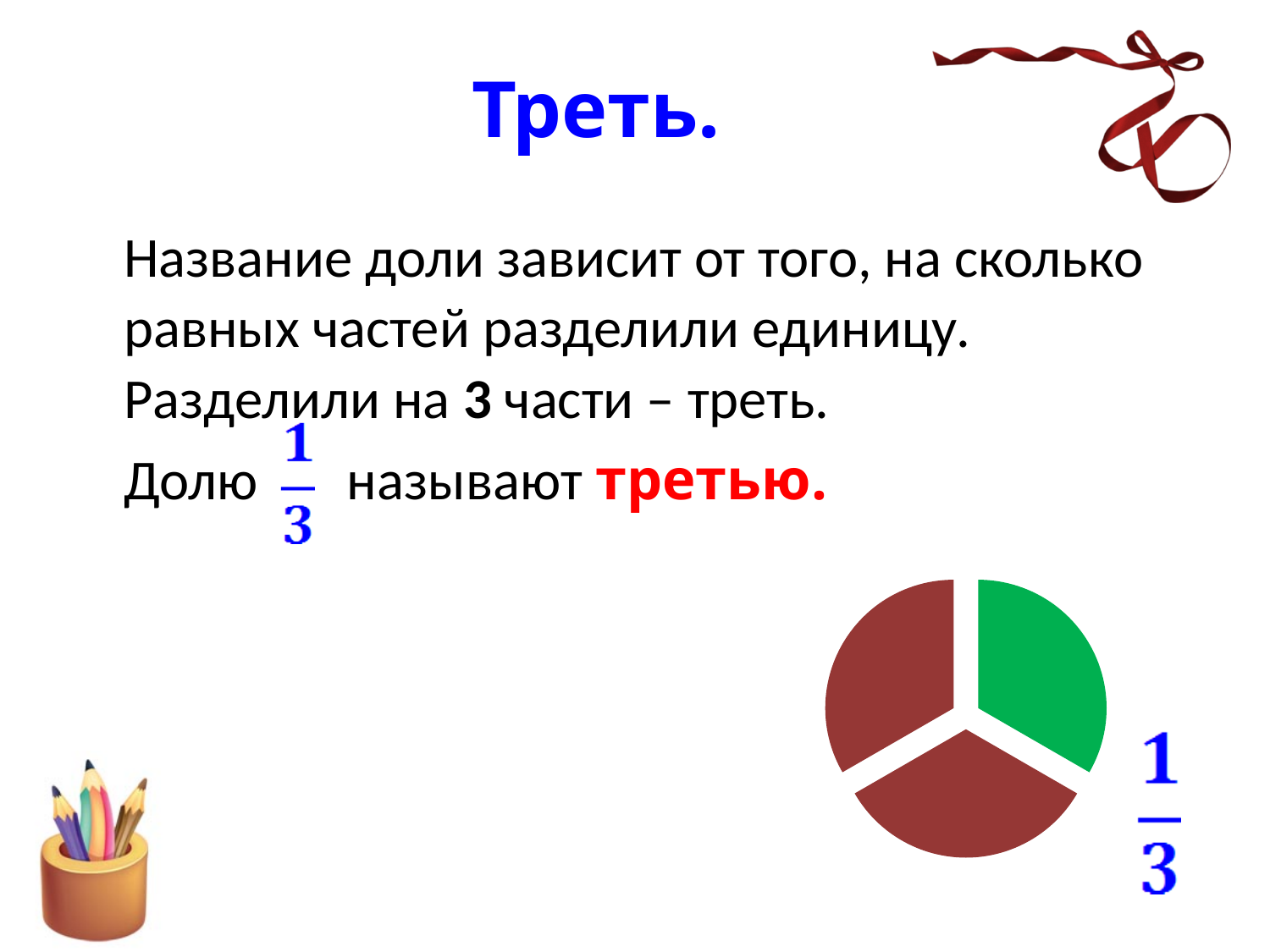
How many slices is the pie chart divided into? 3 What colour are the two slices of the pie chart that are not green? dark red Are the slices of the pie chart equal in size? yes What kind of chart is shown on the slide? pie chart What fraction of the pie does the green slice represent, according to the label next to the chart? 1/3 How many slices of the pie chart are coloured green? 1